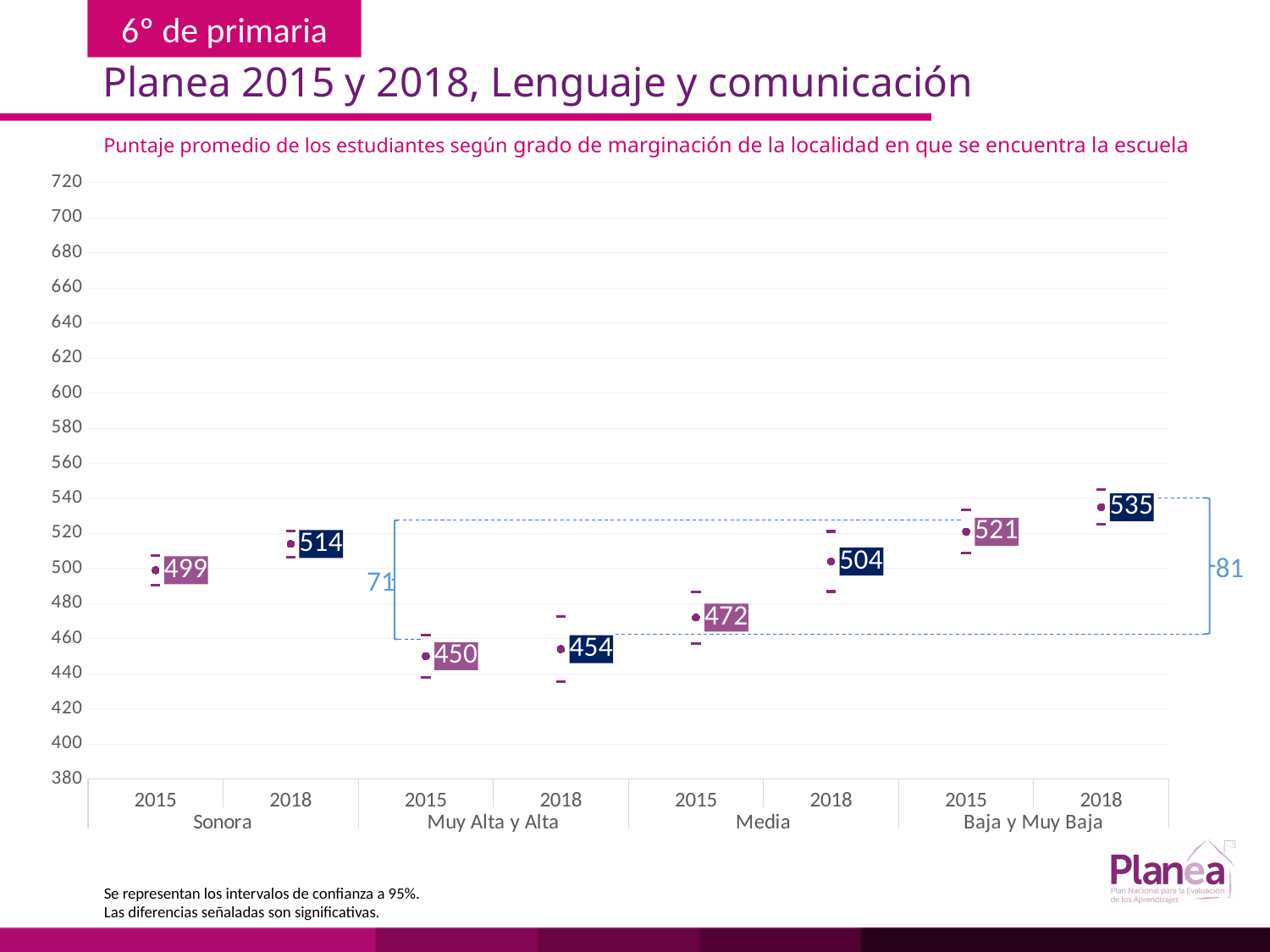
Which is larger, the 2018 score for Muy Alta y Alta or the 2015 score for Media? 2015 score for Media (472) What is the difference between the 2018 and 2015 average scores for Sonora? 15 Which group and year has the lowest average score on the chart? Muy Alta y Alta, 2015 (450) Which group and year has the highest average score on the chart? Baja y Muy Baja, 2018 (535) What is the 2018 average score for Sonora? 514 What is the 2015 average score for the Baja y Muy Baja marginación group? 521 What is the difference between the 2018 and 2015 average scores for the Media group? 32 What is the 2015 average score for the Muy Alta y Alta marginación group? 450 What is the 2018 average score for the Media marginación group? 504 What is the subtitle of the chart? Puntaje promedio de los estudiantes según grado de marginación de la localidad en que se encuentra la escuela Did the average score rise or fall from 2015 to 2018 in every marginación group shown? Rise How many data points are plotted on the chart? 8